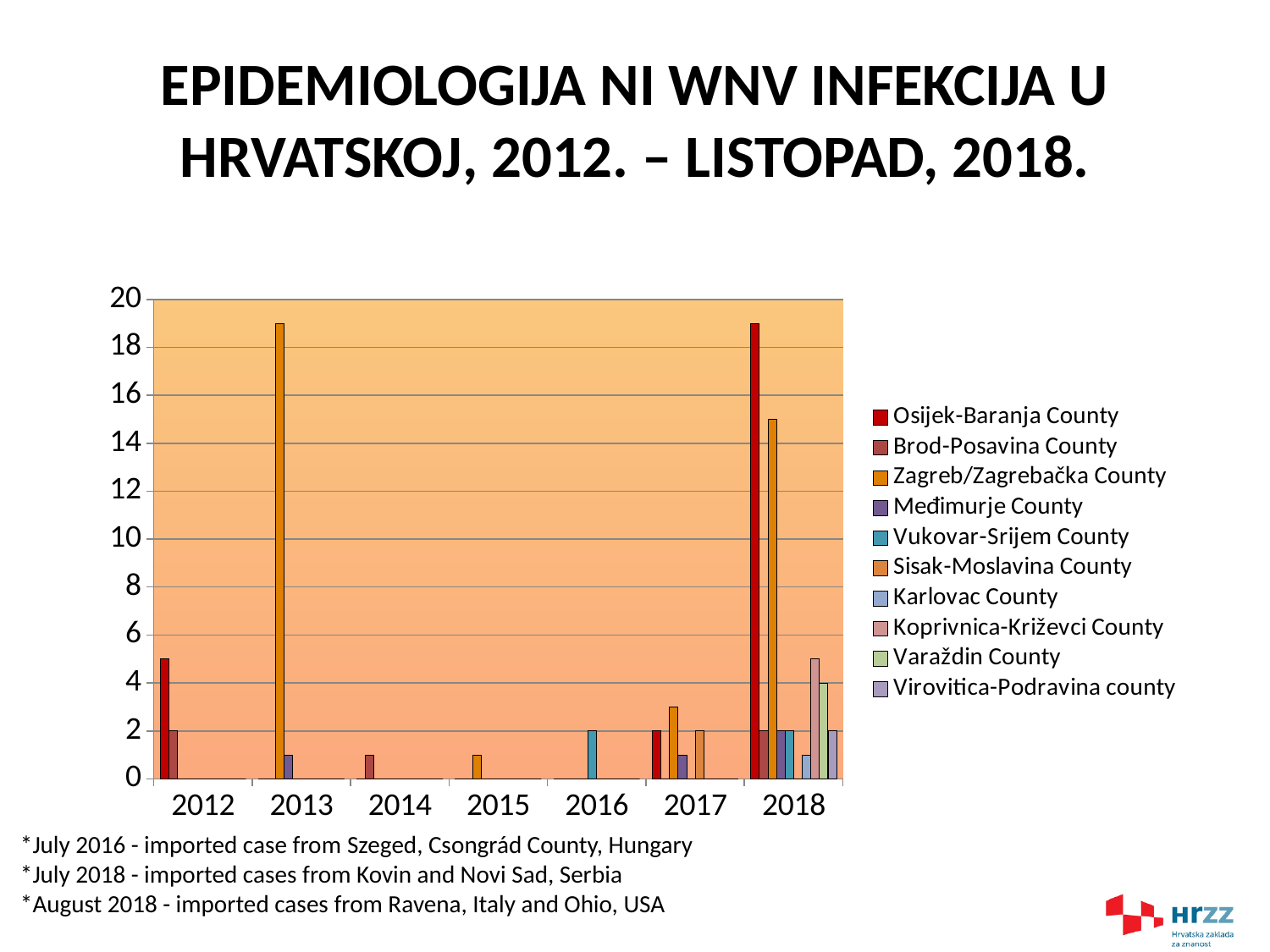
What is the value for Varaždin County in 2018? 4 Is the value for Zagreb/Zagrebačka County in 2013 greater or less than 18? greater What is the value for Vukovar-Srijem County in 2016? 2 How many years are shown along the x axis of the chart? 7 How many series (counties) does the chart legend list? 10 Which colour represents Osijek-Baranja County in the chart legend? red Is the value for Zagreb/Zagrebačka County in 2018 greater or less than 14? greater What kind of chart is shown on the slide? bar chart Which is larger: the value for Zagreb/Zagrebačka County in 2013 or in 2018? 2013 Which is larger in 2018: Osijek-Baranja County or Zagreb/Zagrebačka County? Osijek-Baranja County Is the value for Osijek-Baranja County in 2012 greater or less than 4? greater What is the value for Osijek-Baranja County in 2017? 2